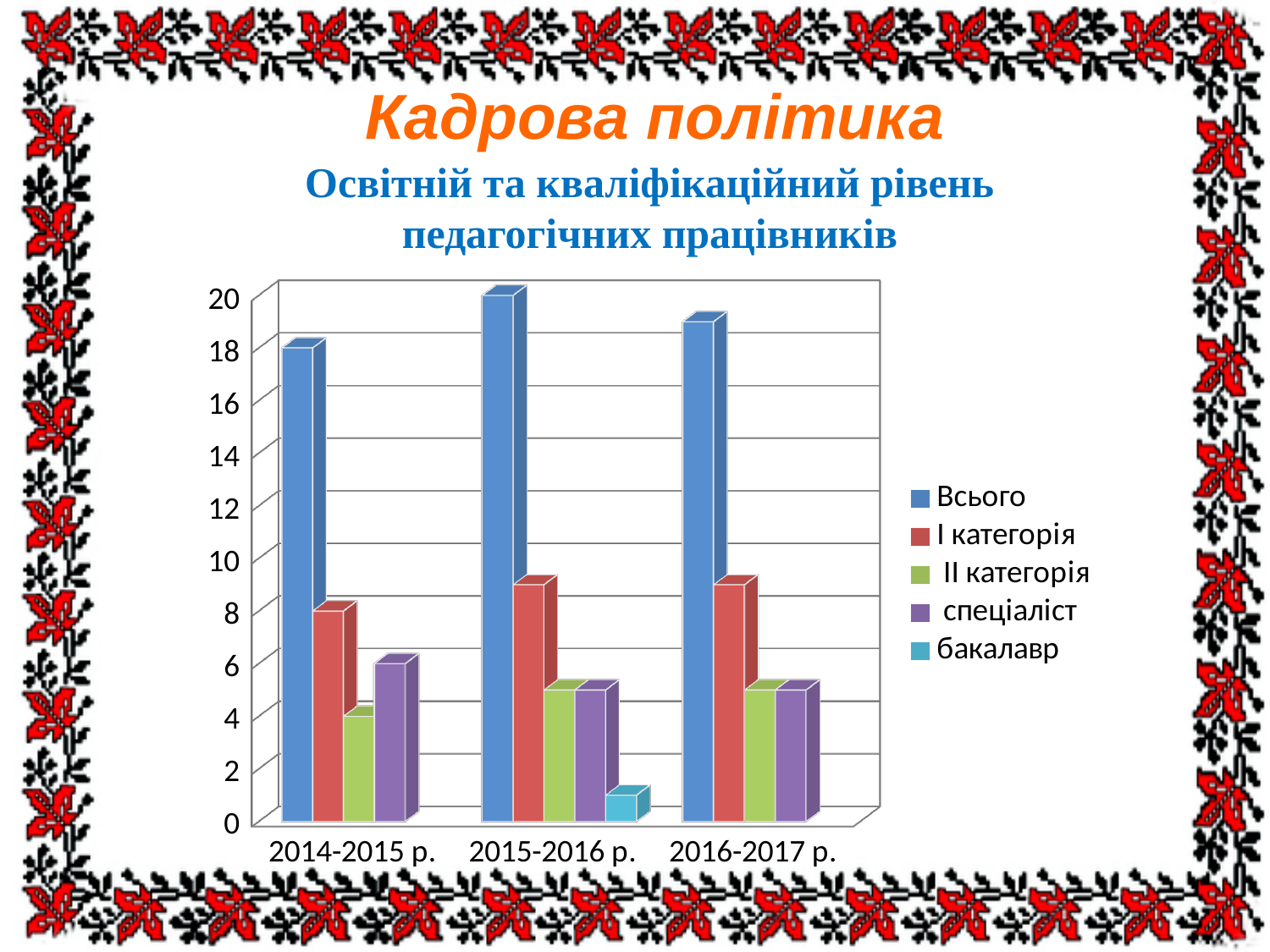
Is the value for бакалавр in 2015-2016 р. greater or less than 2? less In which academic year is the value for Всього highest? 2015-2016 р. In 2014-2015 р., which is larger: спеціаліст or II категорія? спеціаліст Is the value for I категорія in 2015-2016 р. greater or less than 8? greater How many academic years are shown on the x axis? 3 Which series is shown in light blue in the legend? бакалавр In which academic year is the value for Всього lowest? 2014-2015 р. What is the value for Всього in 2014-2015 р.? 18 What kind of chart is shown on the slide? bar chart How many series does the legend list? 5 What is the value for Всього in 2015-2016 р.? 20 Which is larger: Всього in 2016-2017 р. or Всього in 2014-2015 р.? 2016-2017 р.